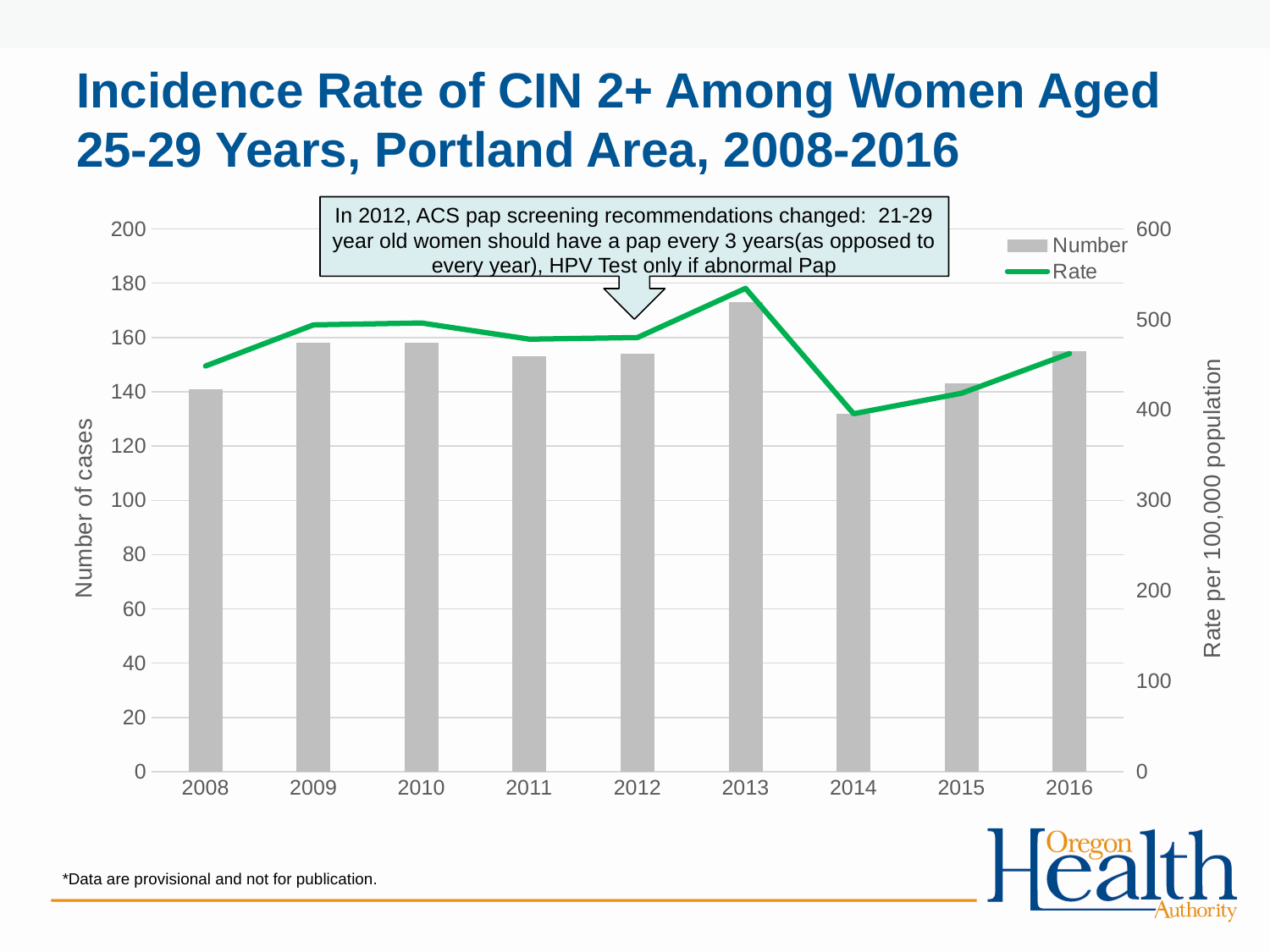
Which year has the highest number of cases? 2013 Is the rate in 2013 greater or less than 500 per 100,000 population? greater In which year is the rate per 100,000 population highest? 2013 Is the number of cases in 2013 greater or less than 160? greater Is the number of cases in 2014 greater or less than 140? less Which year has more cases, 2009 or 2008? 2009 In which year is the rate per 100,000 population lowest? 2014 How many series does the legend list? 2 Is the rate higher in 2013 or in 2016? 2013 Does the rate rise or fall from 2013 to 2014? fall How many years are shown on the x axis? 9 Which year has the lowest number of cases? 2014